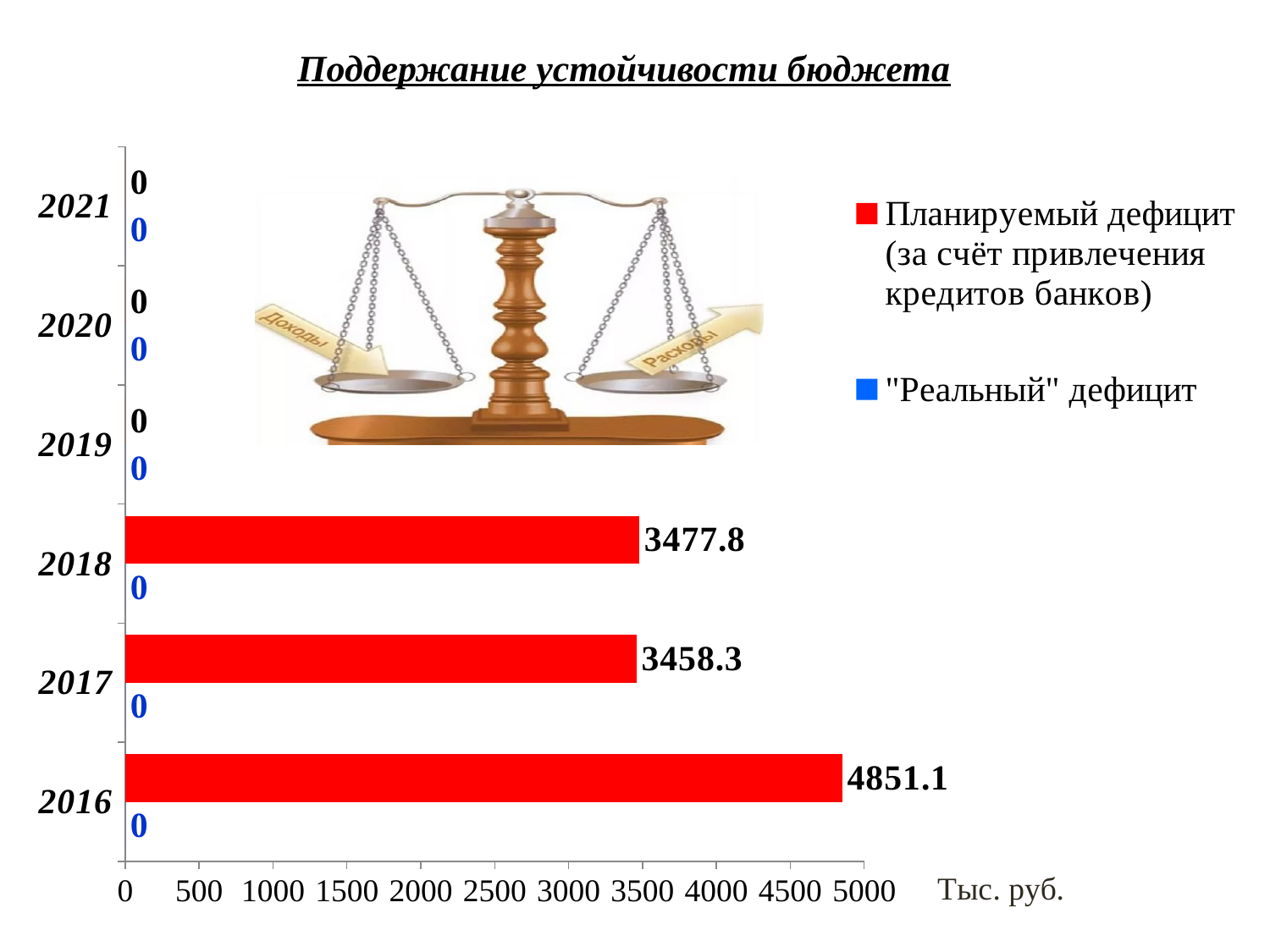
What is the value of the planned deficit (Планируемый дефицит) for 2016? 4851.1 What is the difference between the planned deficit in 2016 and in 2017? 1392.8 How many years (categories) are shown on the chart? 6 What is the difference between the planned deficit in 2018 and in 2017? 19.5 Which year has the highest planned deficit (Планируемый дефицит)? 2016 What is the value of the "real" deficit ("Реальный" дефицит) for 2018? 0 What is the value of the planned deficit (Планируемый дефицит) for 2018? 3477.8 What unit is indicated next to the horizontal axis of the chart? Тыс. руб. Which is larger, the planned deficit in 2016 or in 2018? 2016 What is the value of the planned deficit (Планируемый дефицит) for 2017? 3458.3 What kind of chart is shown on the slide? bar chart How many series does the legend list? 2